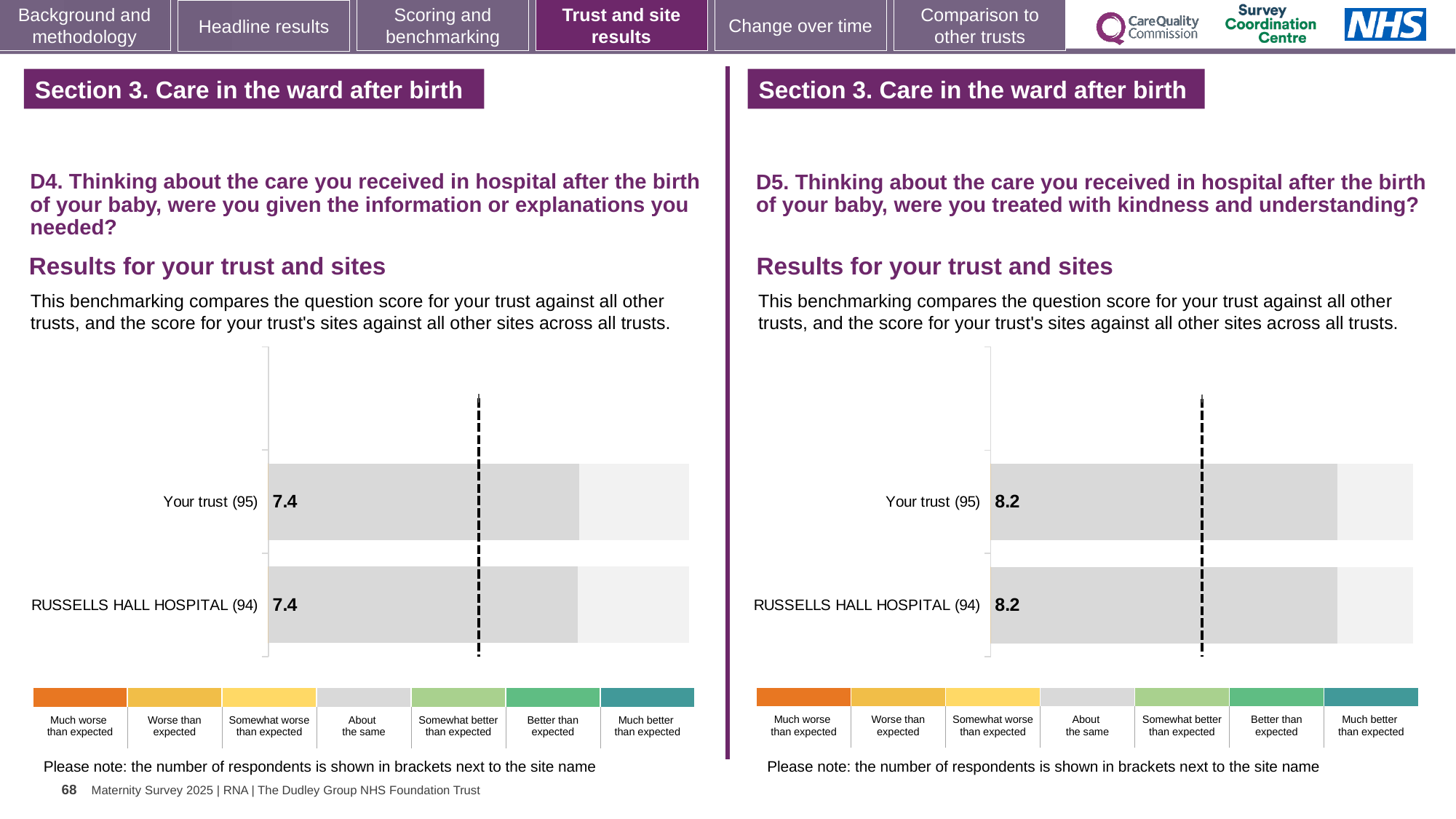
How many bars are plotted in the left chart (D4)? 2 What kind of chart is used in the left chart (D4)? Bar chart In the right chart (D5), how many respondents are shown in brackets for RUSSELLS HALL HOSPITAL? 94 In the right chart (D5), what is the score for Your trust? 8.2 In the left chart (D4), what is the score for Your trust? 7.4 How many bars are plotted in the right chart (D5)? 2 How many benchmarking categories are shown in the colour key below the left chart (D4)? 7 In the left chart (D4), what is the score for RUSSELLS HALL HOSPITAL? 7.4 In the left chart (D4), is the score for Your trust the same as the score for RUSSELLS HALL HOSPITAL? Yes In the right chart (D5), what is the score for RUSSELLS HALL HOSPITAL? 8.2 What is the difference between the Your trust score in the right chart (D5) and the Your trust score in the left chart (D4)? 0.8